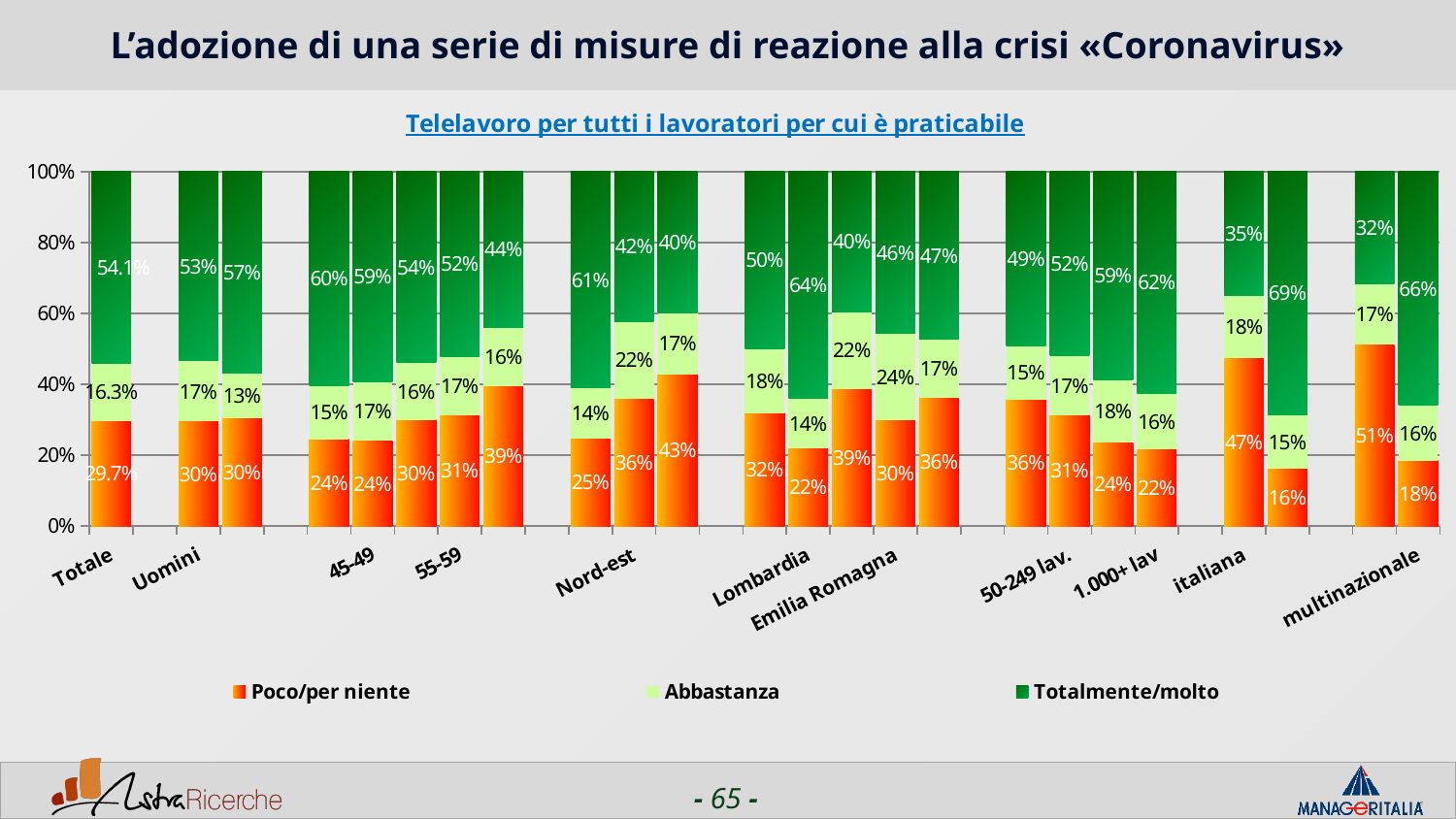
What is the Poco/per niente value for Totale? 29.7% What is the Abbastanza value for Uomini? 17% What is the Abbastanza value for Totale? 16.3% What kind of chart is shown on the slide? Stacked bar chart What is the Poco/per niente value for Uomini? 30% For Totale, which is larger: the Totalmente/molto share or the Poco/per niente share? Totalmente/molto What is the Totalmente/molto value for Uomini? 53% What are the three legend entries of the chart? Poco/per niente, Abbastanza, Totalmente/molto Which has the higher Totalmente/molto value: Totale or Uomini? Totale For Uomini, what is the difference between the Totalmente/molto value and the Poco/per niente value? 23 percentage points What is the Totalmente/molto value for Totale? 54.1% How many series does the legend list? 3